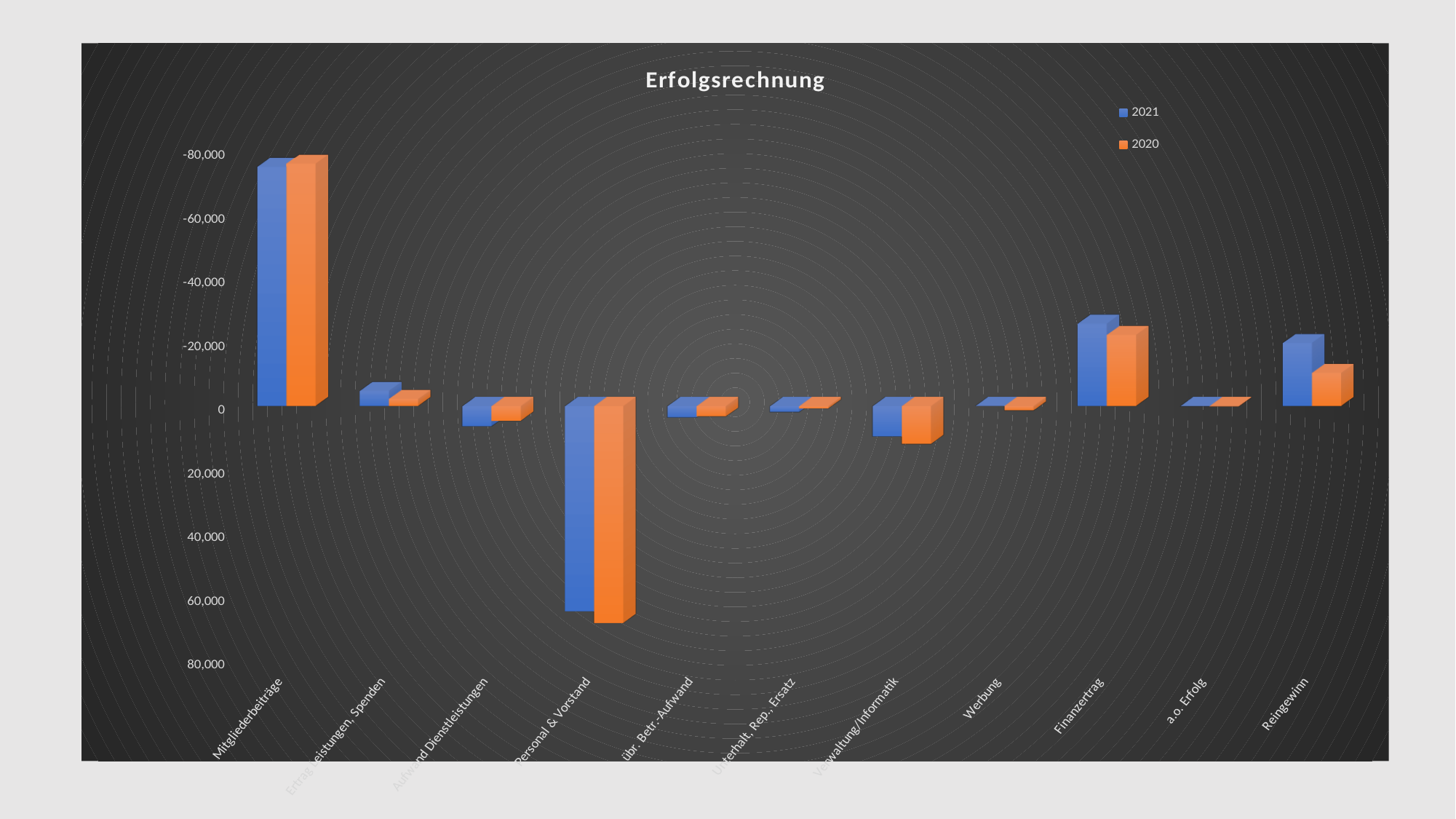
Is the value for Mitgliederbeiträge in 2021 numerically greater or less than -60,000? less Which category has the highest (most positive) value in 2021? Personal & Vorstand Which years are listed in the legend? 2021 and 2020 What type of chart is shown on the slide? bar chart Which category has the lowest (most negative) value in 2021? Mitgliederbeiträge Is the value for Personal & Vorstand in 2020 greater or less than 40,000? greater What is the title of the chart? Erfolgsrechnung For Reingewinn, which year's bar extends further from zero, 2021 or 2020? 2021 How many categories are shown on the x axis? 11 Is the value for Personal & Vorstand in 2021 greater or less than 40,000? greater How many series does the legend list? 2